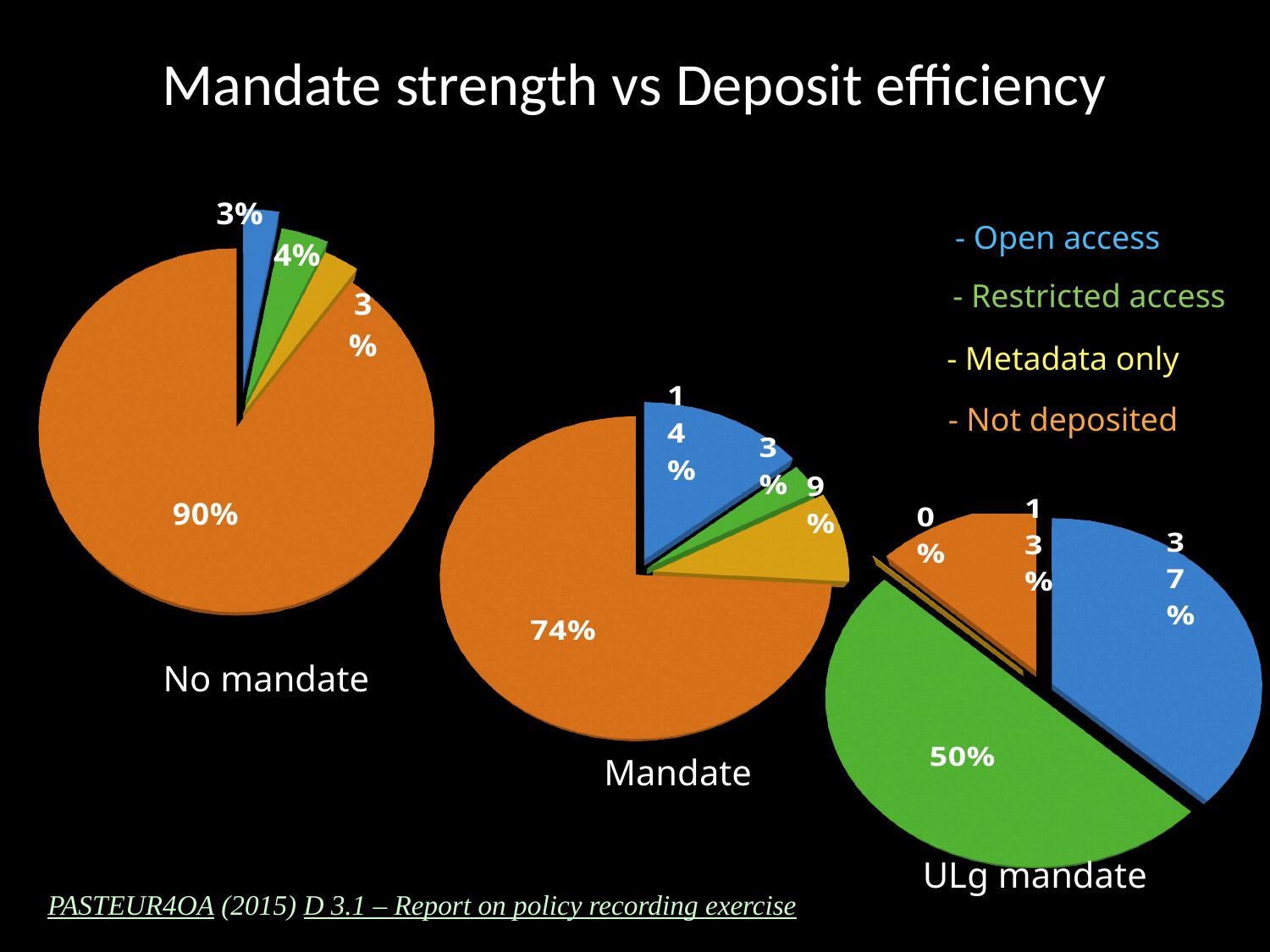
In the "Mandate" pie chart, what share is labelled for Not deposited? 74% Which is larger: the Open access share in the "Mandate" chart or the Open access share in the "ULg mandate" chart? ULg mandate How many categories does the legend list? 4 In the "ULg mandate" pie chart, which category has the largest slice? Restricted access In the "ULg mandate" pie chart, which category has the smallest slice? Metadata only In the "No mandate" pie chart, which category has the largest slice? Not deposited In the "ULg mandate" pie chart, what share is labelled for Open access? 37% In the "ULg mandate" pie chart, what share is labelled for Restricted access? 50% In the "Mandate" pie chart, what share is labelled for Metadata only? 9% How many pie charts are shown on the slide? 3 What is the difference between the Not deposited share in the "No mandate" chart and the Not deposited share in the "Mandate" chart? 16% In the "No mandate" pie chart, what share is labelled for Not deposited? 90%